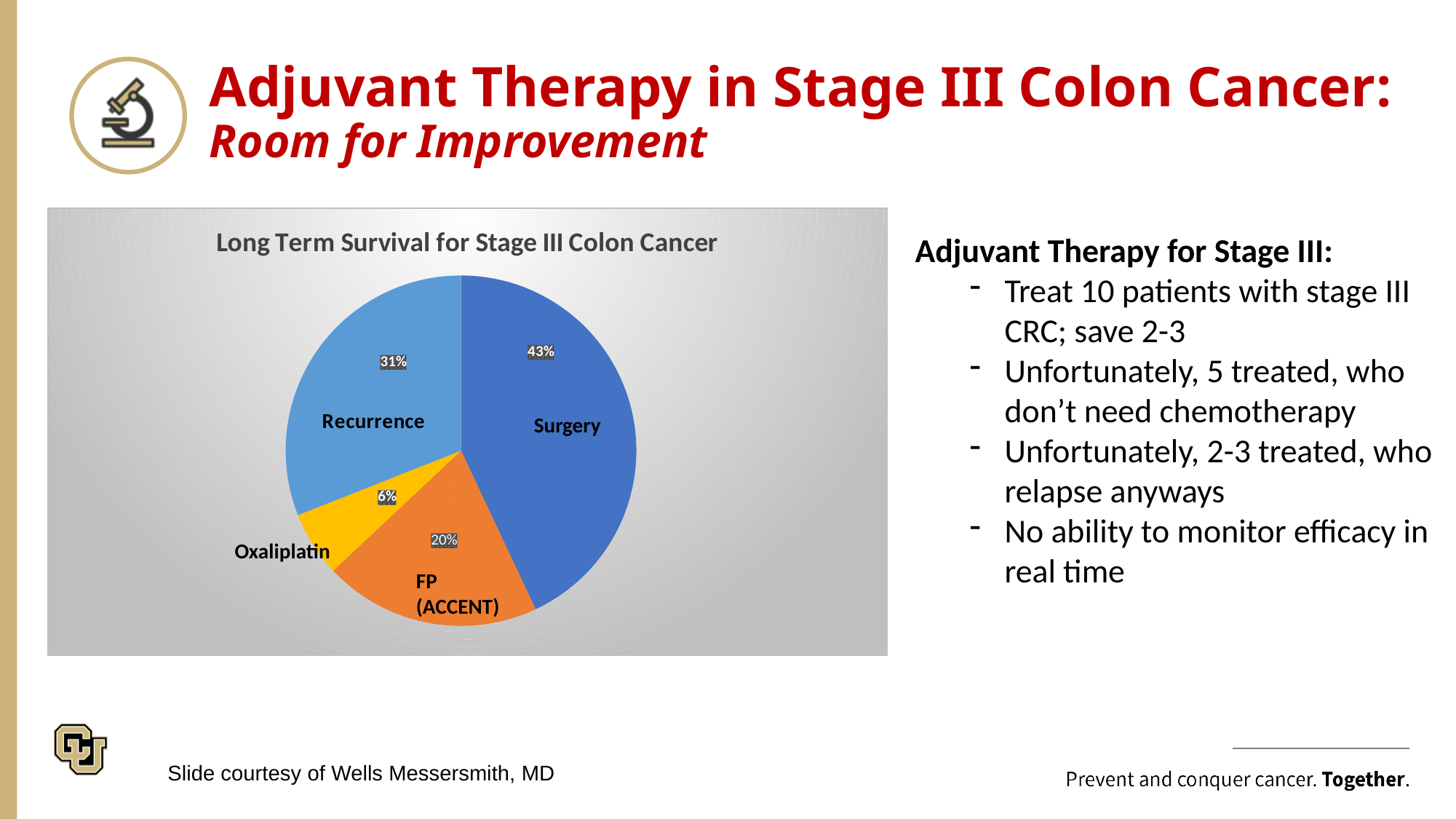
Which slice of the pie is the smallest? Oxaliplatin Which is larger, the FP (ACCENT) slice or the Oxaliplatin slice? FP (ACCENT) What percentage does the Oxaliplatin slice represent? 6% What is the difference in percentage points between the Surgery and Recurrence slices? 12 What percentage does the Surgery slice represent? 43% What type of chart is shown on the slide? pie chart What is the title of the chart? Long Term Survival for Stage III Colon Cancer What colour is the Oxaliplatin slice? yellow Which slice of the pie is the largest? Surgery What percentage does the FP (ACCENT) slice represent? 20% What percentage does the Recurrence slice represent? 31%